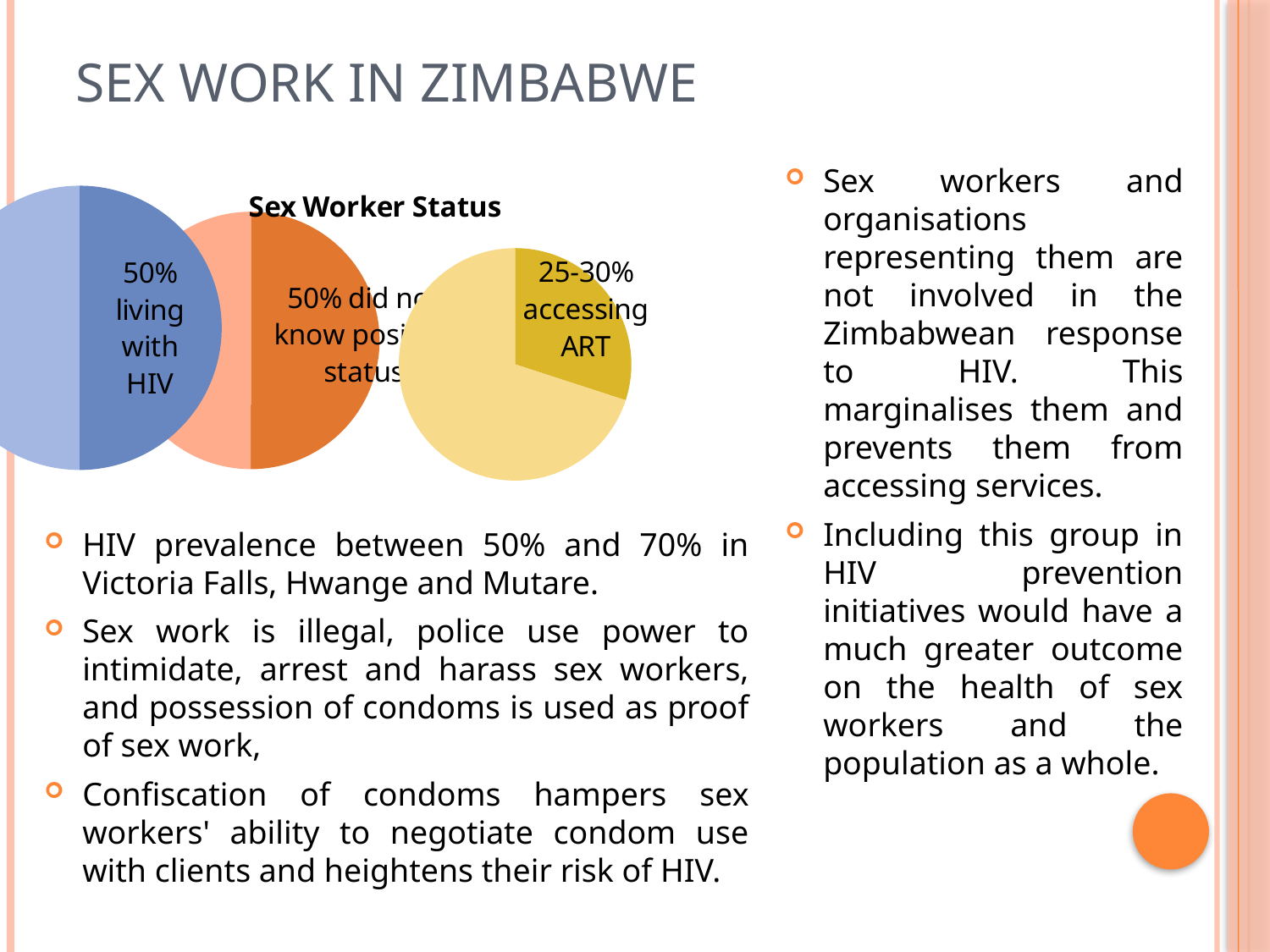
In the Sex Worker Status chart, what percentage of sex workers did not know their positive status? 50% In the Sex Worker Status chart, is the share accessing ART greater or less than 50%? less What colour is the pie chart showing the share accessing ART? Yellow What kind of chart is used on the slide to show Sex Worker Status? Pie chart How many separate pie charts make up the Sex Worker Status chart? 3 In the Sex Worker Status chart, what percentage of sex workers are shown as accessing ART? 25-30% In the Sex Worker Status chart, what percentage of sex workers are shown as living with HIV? 50% In the Sex Worker Status chart, which of the three labelled shares is the smallest? Accessing ART In the Sex Worker Status chart, which is larger: the share living with HIV or the share accessing ART? Living with HIV What is the title of the chart on the slide? Sex Worker Status